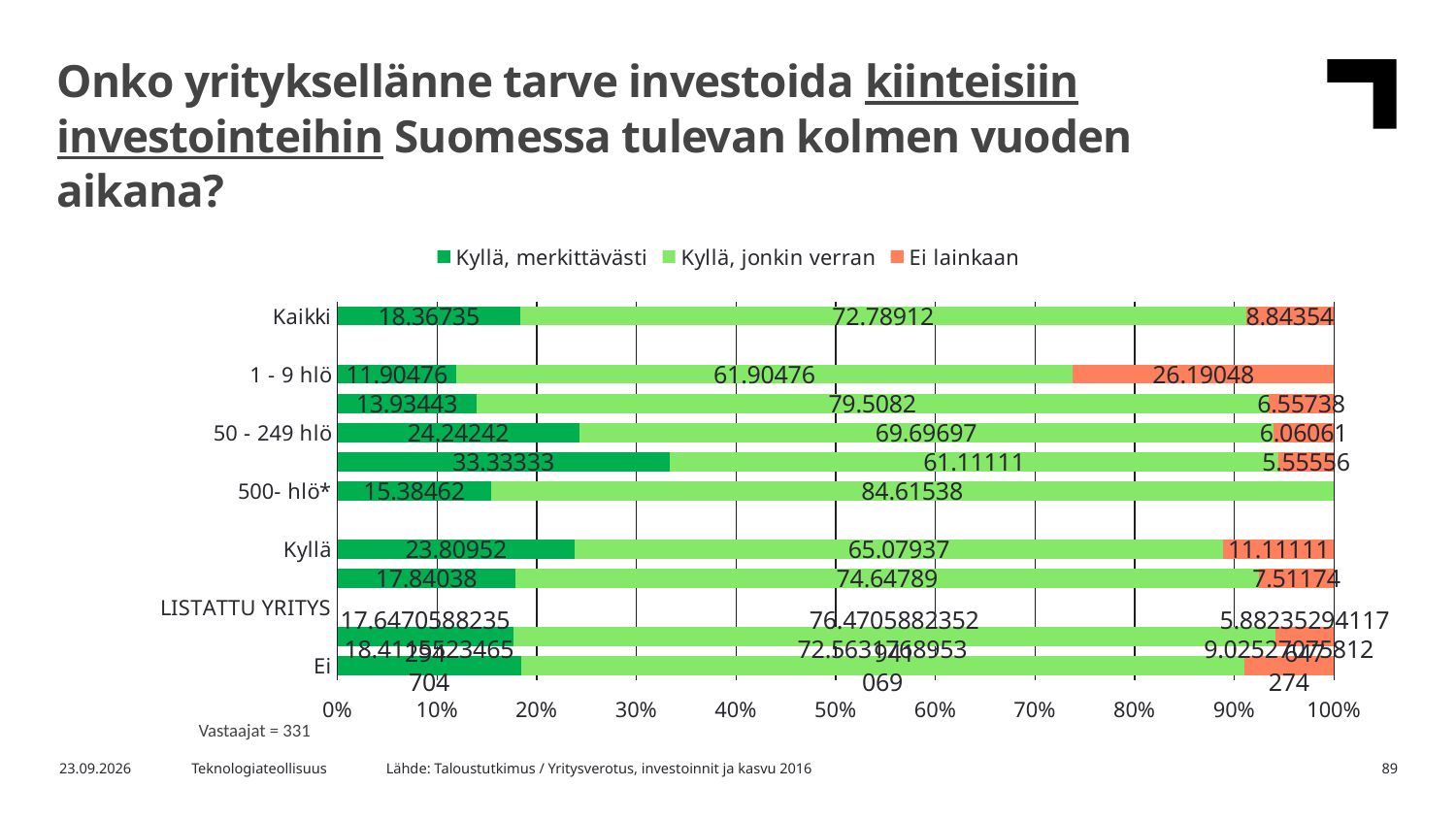
Which has the larger "Ei lainkaan" value: Kaikki or 1 - 9 hlö? 1 - 9 hlö Which has the larger "Kyllä, merkittävästi" value: Kaikki or 50 - 249 hlö? 50 - 249 hlö What is the value of "Ei lainkaan" for the 1 - 9 hlö category? 26.19048 What is the value of "Kyllä, merkittävästi" for the Kaikki category? 18.36735 What colour represents the "Ei lainkaan" series in the chart? Orange What is the value of "Kyllä, merkittävästi" for the 50 - 249 hlö category? 24.24242 What is the value of "Kyllä, jonkin verran" for the 500- hlö* category? 84.61538 What is the value of "Ei lainkaan" for the Kyllä category? 11.11111 What kind of chart is shown on the slide? Stacked bar chart For the Kaikki category, what is the difference between the "Kyllä, jonkin verran" value and the "Kyllä, merkittävästi" value? 54.42177 What is the value of "Kyllä, jonkin verran" for the Kaikki category? 72.78912 How many series does the legend list? 3